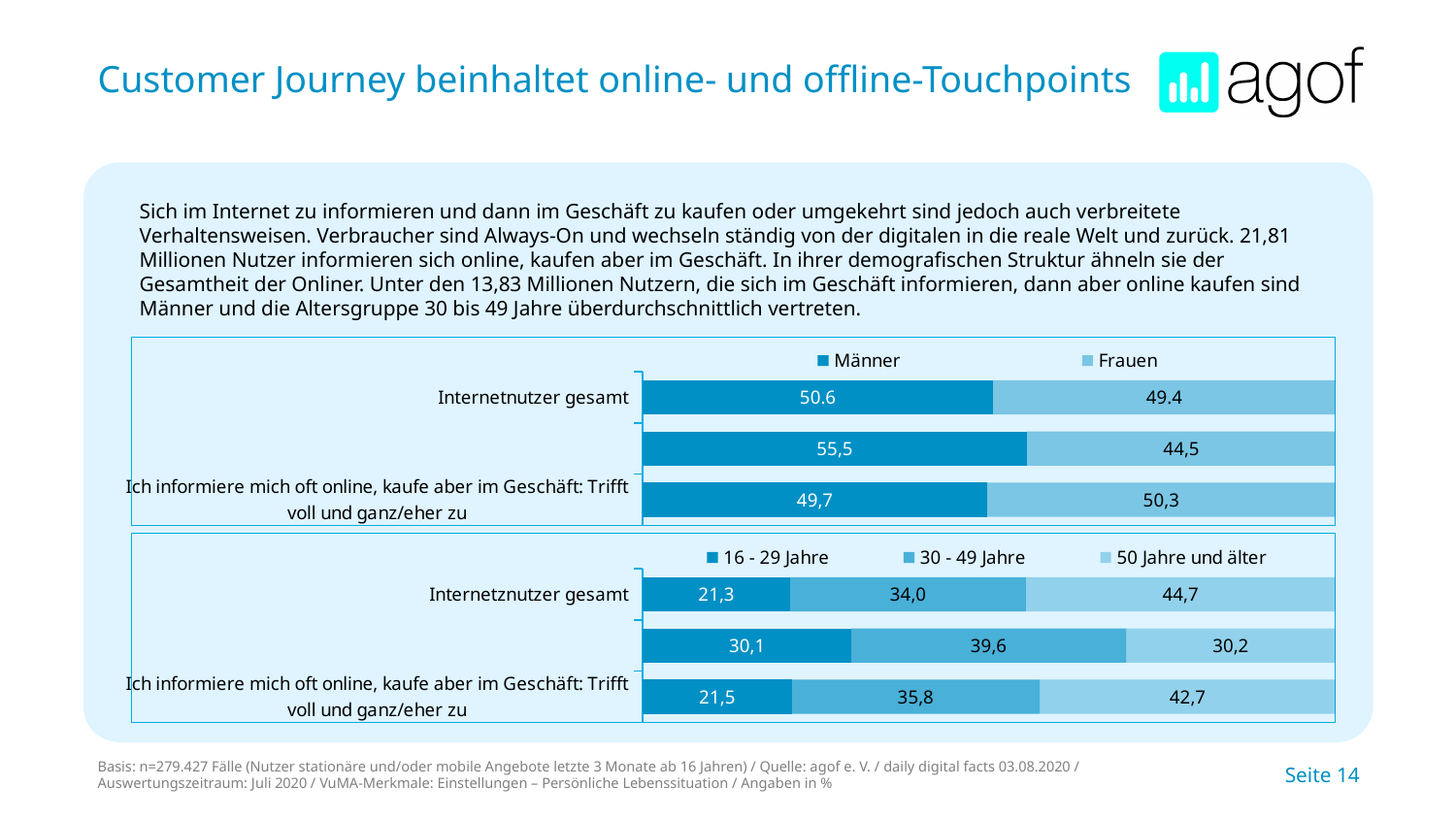
In the bottom chart (age groups), how much larger is the '30 - 49 Jahre' value for 'Ich informiere mich oft online, kaufe aber im Geschäft: Trifft voll und ganz/eher zu' than for 'Internetnutzer gesamt'? 1,8 In the top chart (Männer/Frauen), what is the value for Männer in the 'Internetnutzer gesamt' bar? 50.6 How many series does the legend of the bottom chart (age groups) list? 3 In the top chart (Männer/Frauen), what is the value for Frauen in the bar 'Ich informiere mich oft online, kaufe aber im Geschäft: Trifft voll und ganz/eher zu'? 50,3 In the bottom chart (age groups), which age group has the largest share in the 'Internetnutzer gesamt' bar? 50 Jahre und älter How many series does the legend of the top chart list? 2 In the bottom chart (age groups), which age group has the smallest share in the bar 'Ich informiere mich oft online, kaufe aber im Geschäft: Trifft voll und ganz/eher zu'? 16 - 29 Jahre In the bottom chart (age groups), what is the value for '50 Jahre und älter' in the 'Internetnutzer gesamt' bar? 44,7 In the bottom chart (age groups), what is the value for '16 - 29 Jahre' in the bar 'Ich informiere mich oft online, kaufe aber im Geschäft: Trifft voll und ganz/eher zu'? 21,5 In the top chart (Männer/Frauen), which is larger in the bar 'Ich informiere mich oft online, kaufe aber im Geschäft: Trifft voll und ganz/eher zu': Männer or Frauen? Frauen In the bottom chart (age groups), what is the total of the three segments in the 'Internetnutzer gesamt' bar? 100,0 What kind of chart is used on this slide? Stacked bar chart